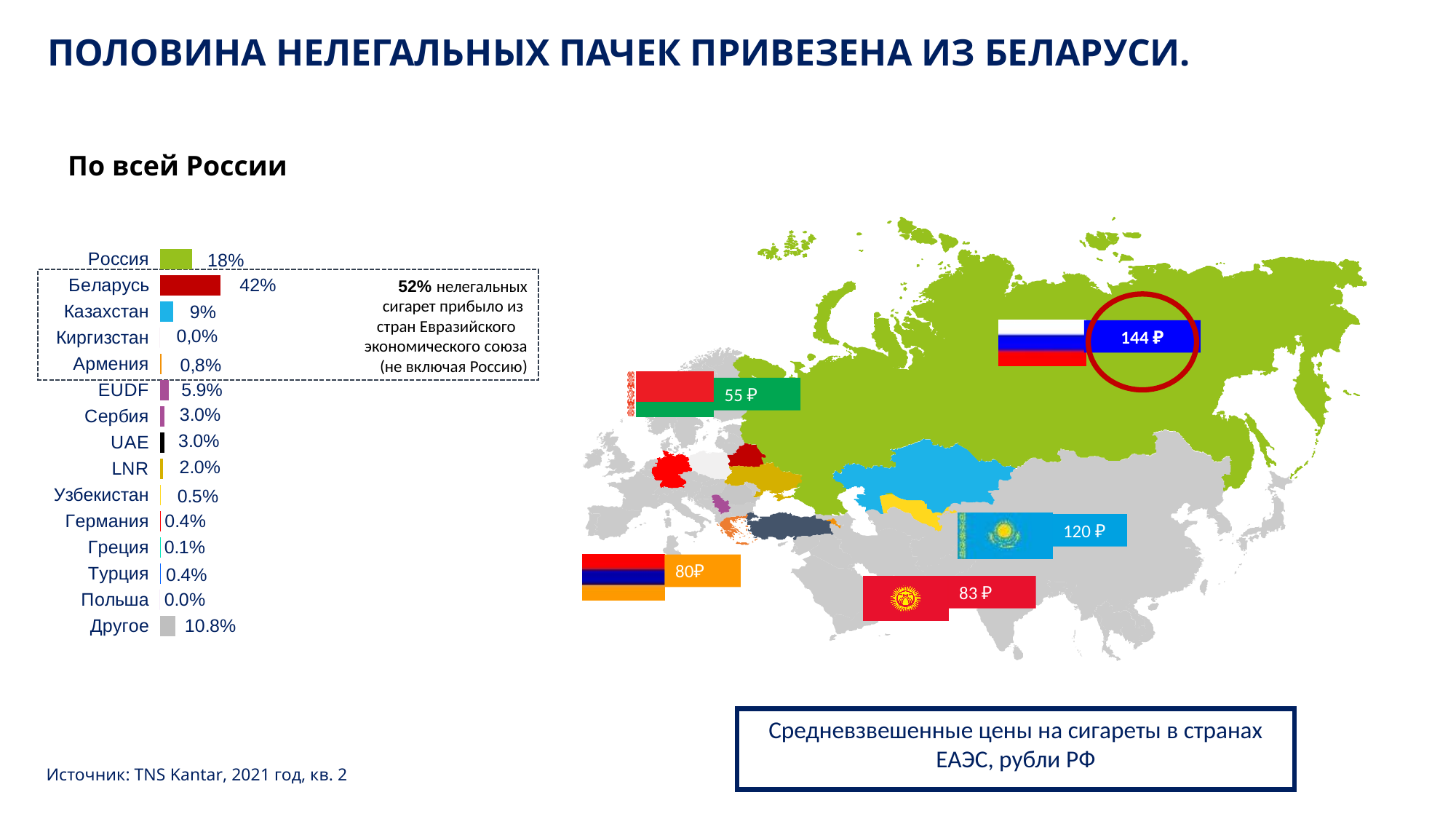
In the bar chart 'По всей России', what is the value for Другое? 10.8% What kind of chart is 'По всей России'? bar chart In the bar chart 'По всей России', what is the value for Армения? 0,8% How many categories are shown in the bar chart 'По всей России'? 15 On the map of average cigarette prices in EAEU countries, what is the difference between the prices for Russia and Belarus? 89 ₽ In the bar chart 'По всей России', which category has the highest value? Беларусь On the map of average cigarette prices in EAEU countries, what is the price shown for Belarus? 55 ₽ What is the title of the bar chart on the left of the slide? По всей России In the bar chart 'По всей России', what is the value for Беларусь? 42% On the map of average cigarette prices in EAEU countries, which country has the highest price? Russia (144 ₽) In the bar chart 'По всей России', which is larger, the value for Казахстан or the value for EUDF? Казахстан In the bar chart 'По всей России', what is the difference between the values for Беларусь and Россия? 24%